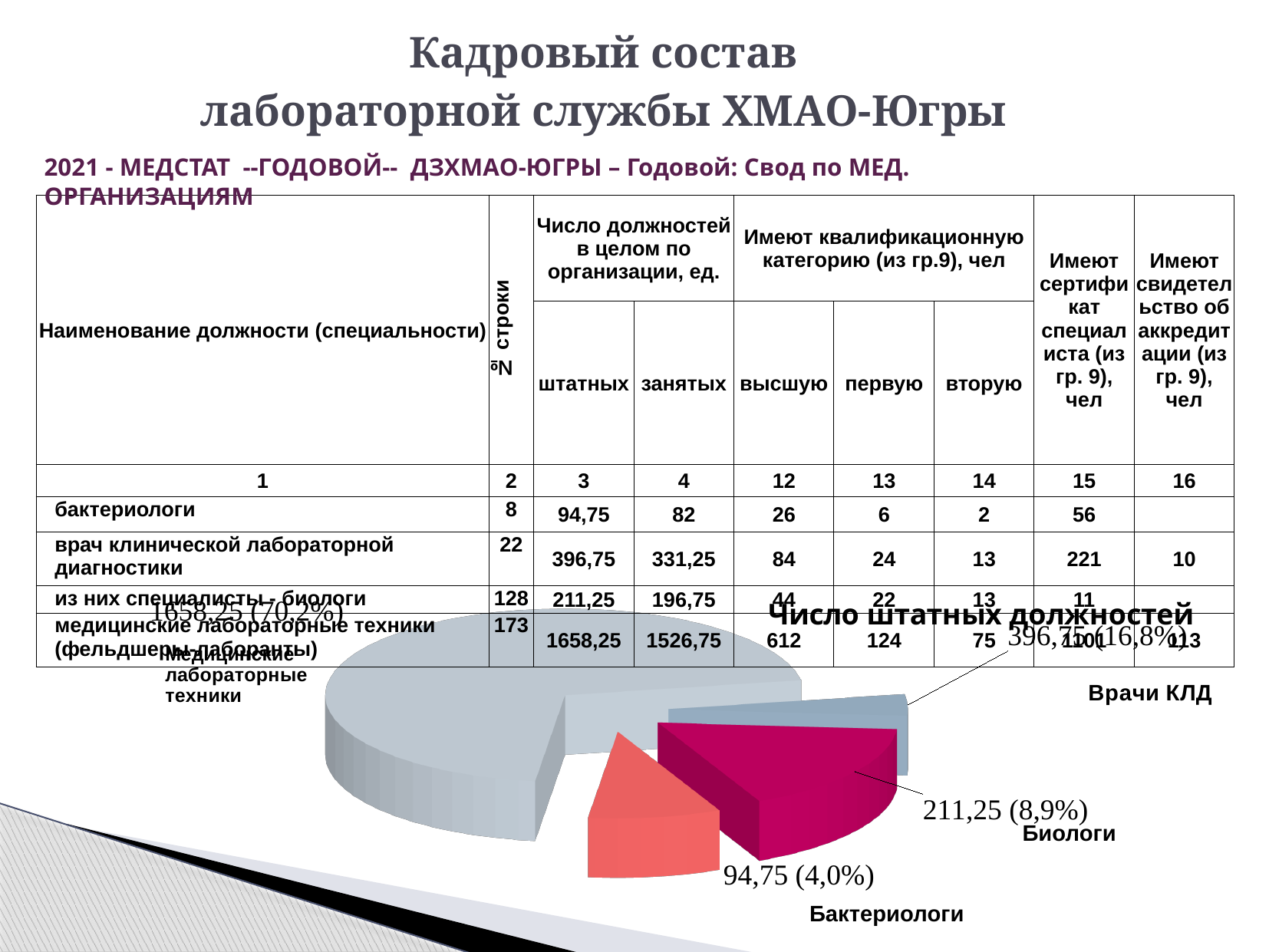
What type of chart is shown on the slide? pie chart What share of the pie does Врачи КЛД represent? 16,8% Which category has the smallest slice in the pie chart? Бактериологи Which is larger in the pie chart, Врачи КЛД or Биологи? Врачи КЛД What value is shown for Бактериологи in the pie chart? 94,75 Which category has the largest slice in the pie chart? Медицинские лабораторные техники What value is shown for Медицинские лабораторные техники in the pie chart? 1658,25 What share of the pie does Биологи represent? 8,9% What value is shown for Биологи in the pie chart? 211,25 How many slices does the pie chart have? 4 What is the title of the pie chart? Число штатных должностей What value is shown for Врачи КЛД in the pie chart? 396,75